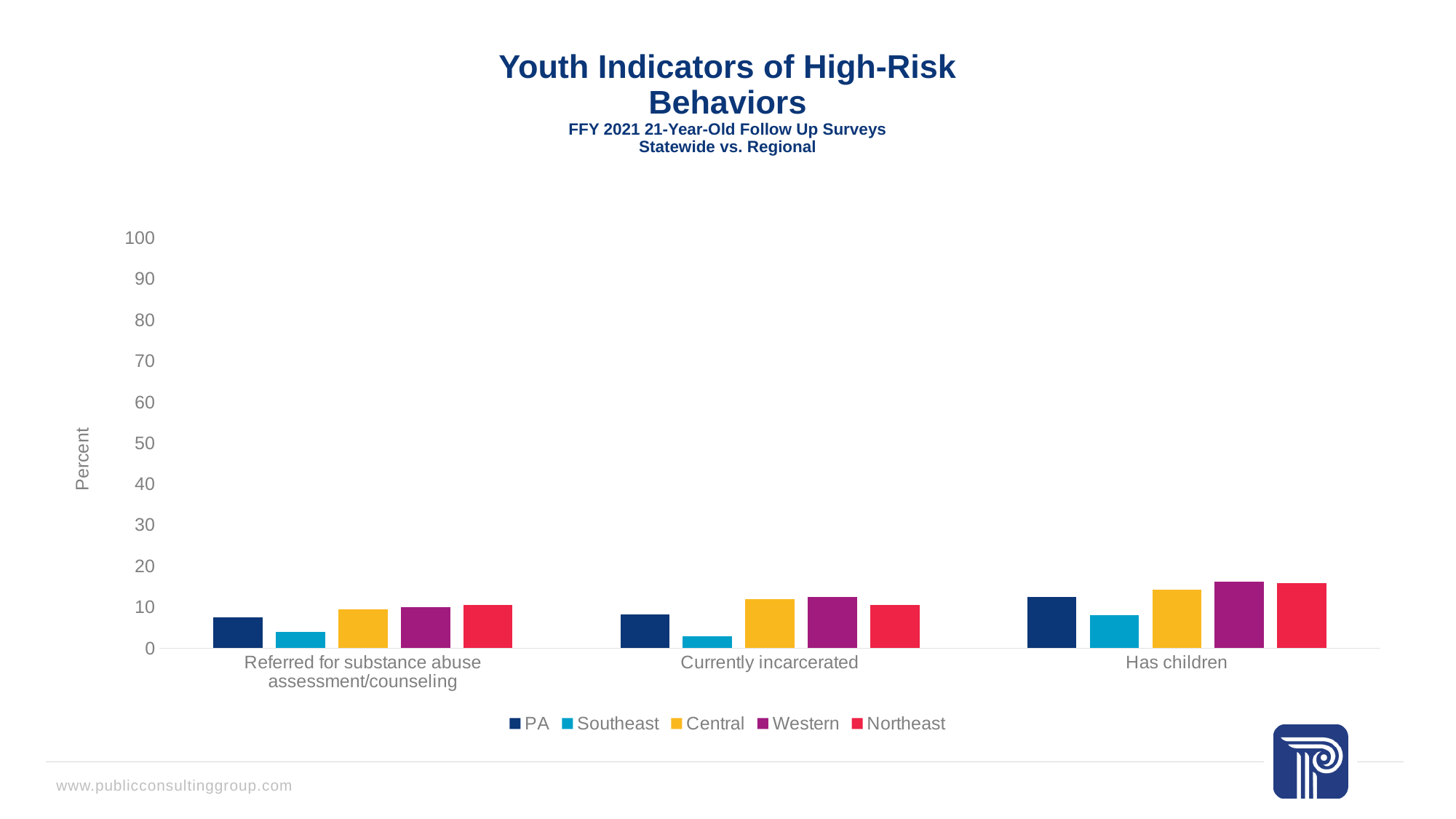
In the 'Currently incarcerated' category, which is larger: PA or Southeast? PA What is the label on the vertical axis of the chart? Percent Is the value for Southeast in the 'Referred for substance abuse assessment/counseling' category greater or less than 10? less How many categories are shown on the x axis? 3 Is the value for PA in the 'Referred for substance abuse assessment/counseling' category greater or less than 10? less Which series has the lowest value in the 'Currently incarcerated' category? Southeast Which series has the lowest value in the 'Has children' category? Southeast In the 'Has children' category, which is larger: Central or Southeast? Central Is the value for Western in the 'Has children' category greater or less than 10? greater What kind of chart is shown on the slide? bar chart How many series does the legend list? 5